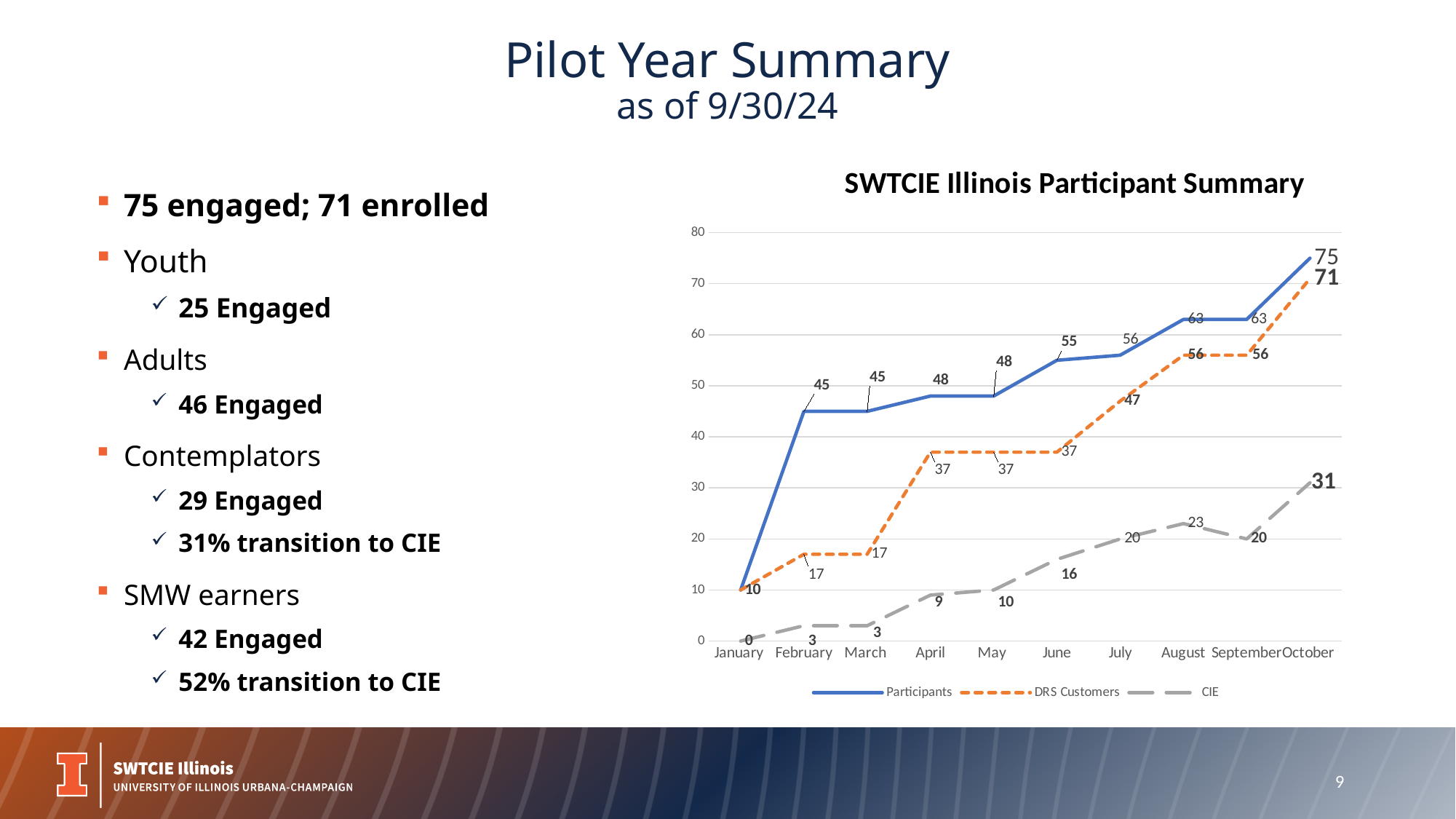
What type of chart is shown on the slide? Line chart What is the difference between the Participants value and the DRS Customers value in October? 4 Which series has the larger value in June, Participants or CIE? Participants What is the value of the DRS Customers series in July? 47 What is the value of the CIE series in August? 23 How many months are plotted along the x axis of the chart? 10 What is the title of the chart? SWTCIE Illinois Participant Summary Does the DRS Customers series generally rise or fall from January to October? Rise What is the value of the Participants series in October? 75 In which month is the Participants series at its lowest? January How many series does the chart legend list? 3 In which month is the CIE series at its highest? October